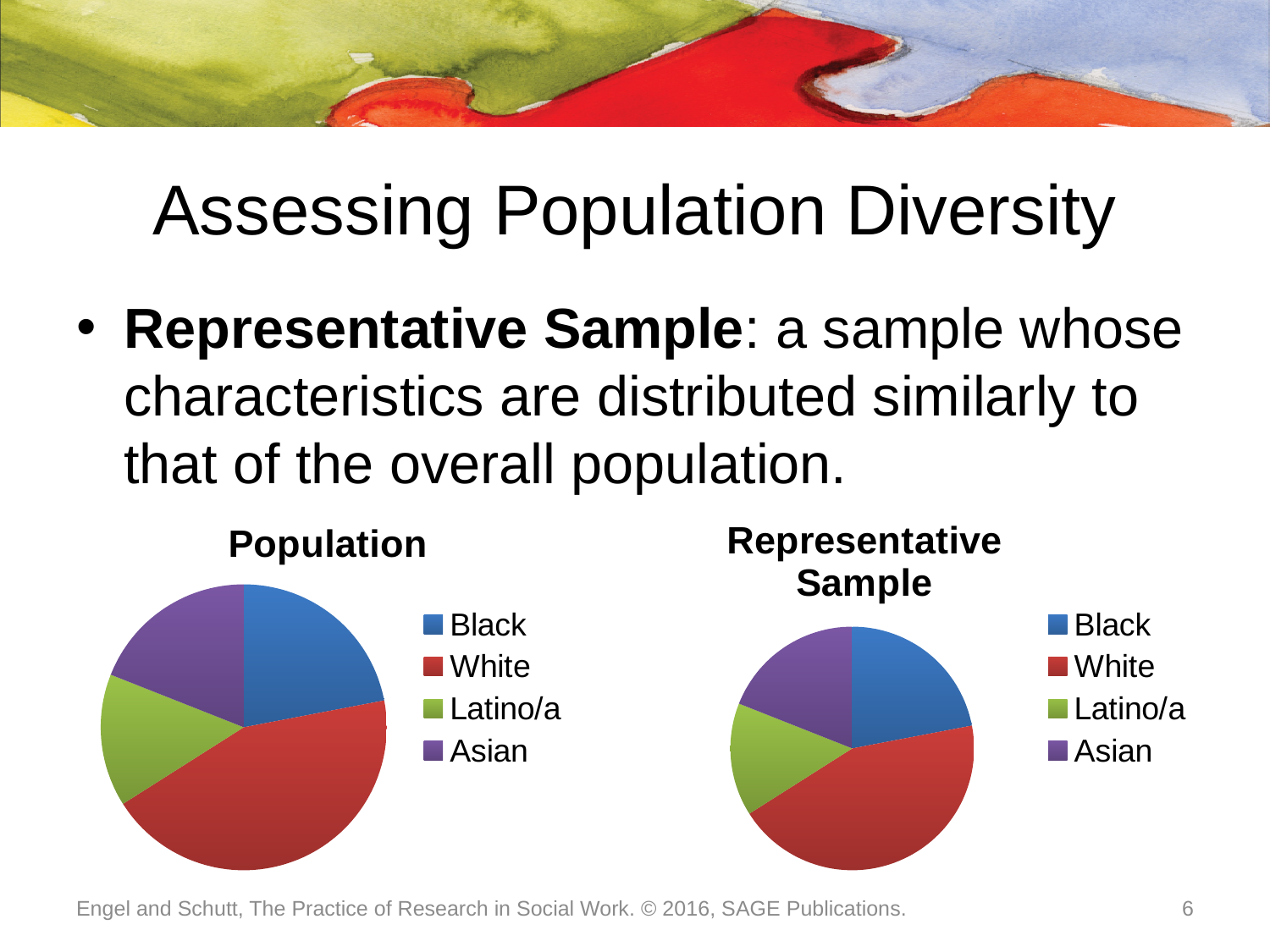
In the Population chart, which slice is larger, White or Asian? White In the Representative Sample chart, what colour represents Latino/a? green In the Representative Sample chart, which category has the largest slice? White In the Population chart, how many slices does the pie have? 4 In the Population chart, which category has the largest slice? White What kind of chart is the Population chart? pie chart In the Population chart, which slice is larger, White or Black? White What kind of chart is the Representative Sample chart? pie chart In the Representative Sample chart, how many categories are shown in the legend? 4 In the Representative Sample chart, which slice is larger, Black or Latino/a? Black What is the title of the pie chart on the left? Population